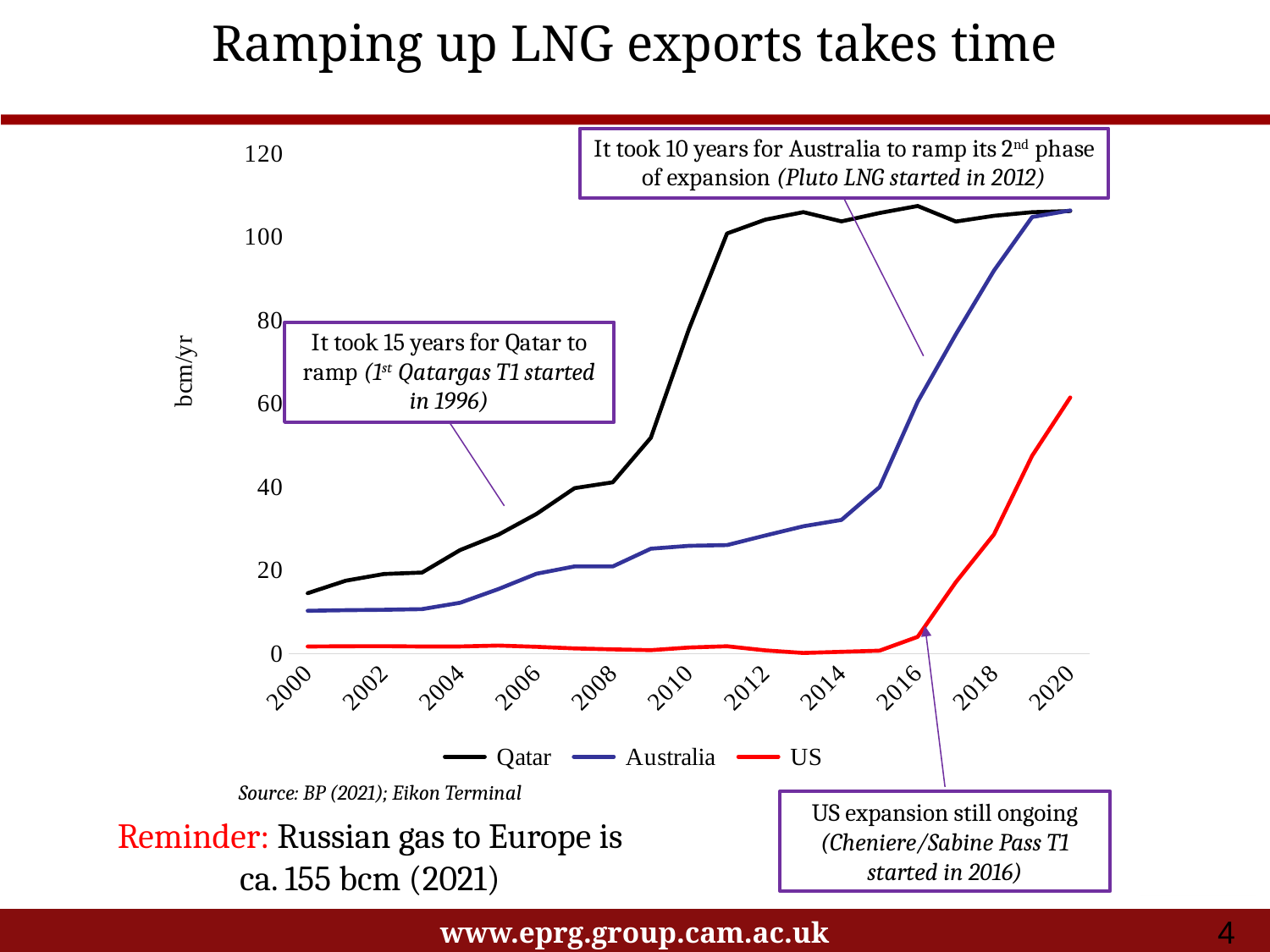
Is the value for Australia in 2010 greater or less than 20? greater What unit is shown on the y axis of the chart? bcm/yr What kind of chart is shown on the slide? line chart Which is larger in 2010, the value for Qatar or the value for Australia? Qatar Which is larger in 2020, the value for US or the value for Australia? Australia Is the value for US in 2020 greater or less than 80? less Do US LNG exports rise or fall between 2016 and 2020? rise How many series does the legend list? 3 Is the value for Qatar in 2016 greater or less than 100? greater How many year labels are shown on the x axis? 11 Which series had the highest LNG exports in 2010? Qatar Which series had the lowest LNG exports in 2018? US